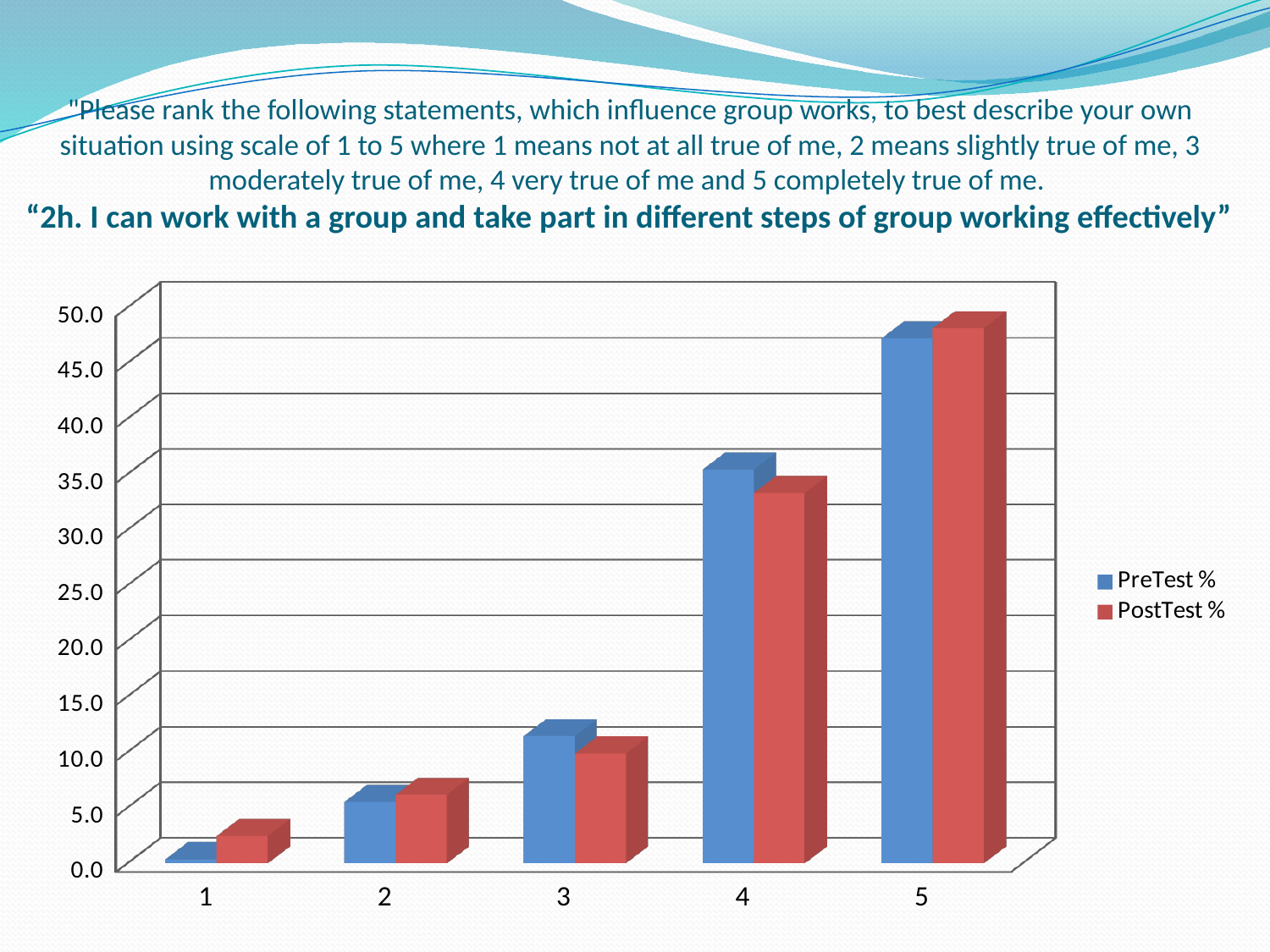
Is the PostTest % value for category 3 greater or less than 15.0? less How many series does the legend list? 2 Which category has the highest PreTest % value? 5 What kind of chart is shown on the slide? bar chart How many categories are shown on the x axis? 5 Which category has the lowest PreTest % value? 1 Which category has the lowest PostTest % value? 1 Do the PostTest % values rise or fall as the categories go from 1 to 5? rise Is the PreTest % value for category 4 greater or less than 30.0? greater Which colour represents the PostTest % series in the legend? red For category 1, which is larger: PreTest % or PostTest %? PostTest % For category 4, which is larger: PreTest % or PostTest %? PreTest %